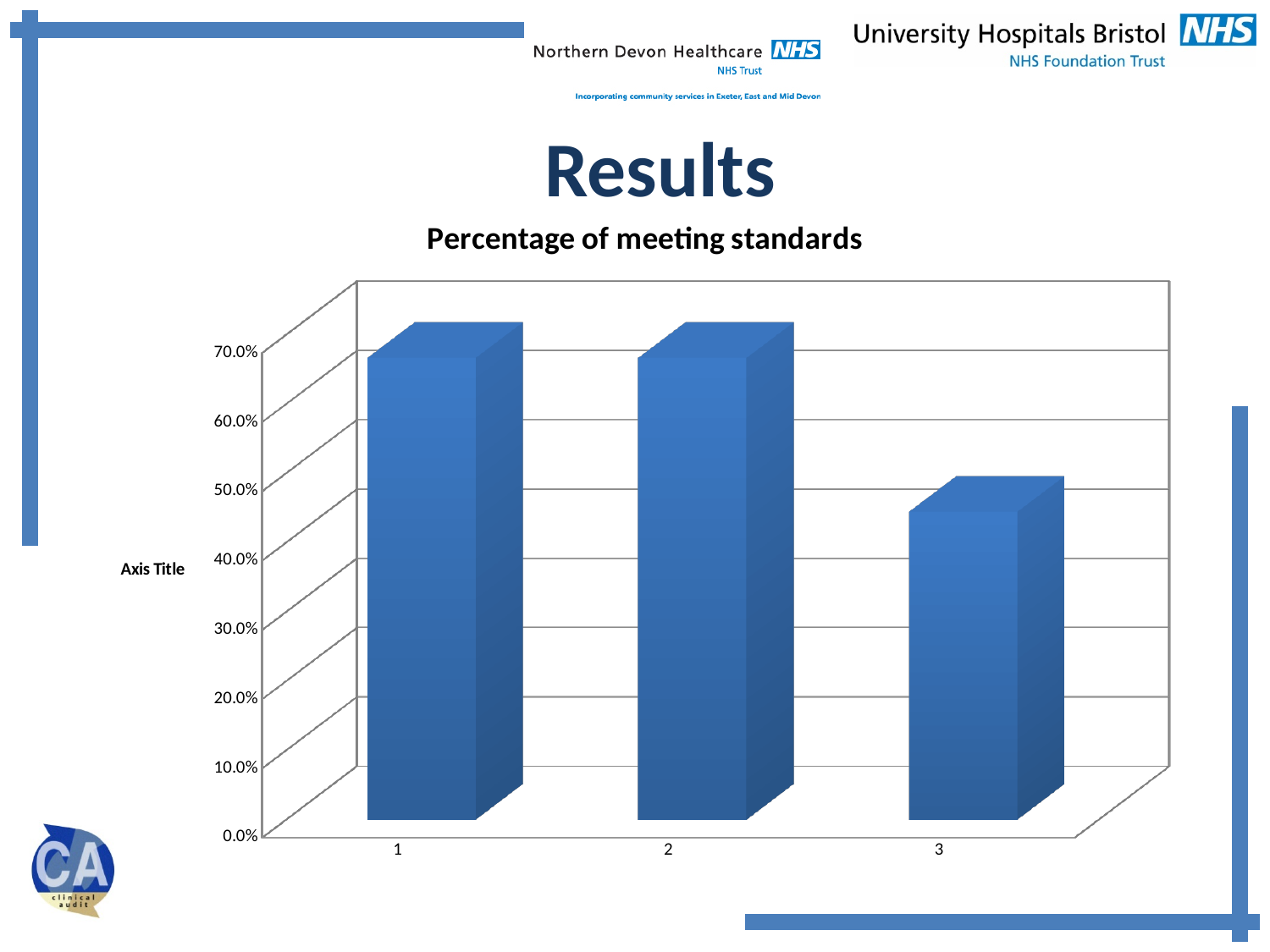
Is the value for category 2 greater or less than 50.0%? greater Is the value for category 3 greater or less than 30.0%? greater Which category has the lowest value in the chart? 3 What label is shown on the vertical axis of the chart? Axis Title What type of chart is shown on the slide? bar chart Which is larger, the value for category 1 or the value for category 3? category 1 What is the title of the chart? Percentage of meeting standards Is the value for category 1 greater or less than 60.0%? greater Which is larger, the value for category 2 or the value for category 3? category 2 What is the highest value shown on the vertical axis scale? 70.0% How many bars (categories) are plotted in the chart? 3